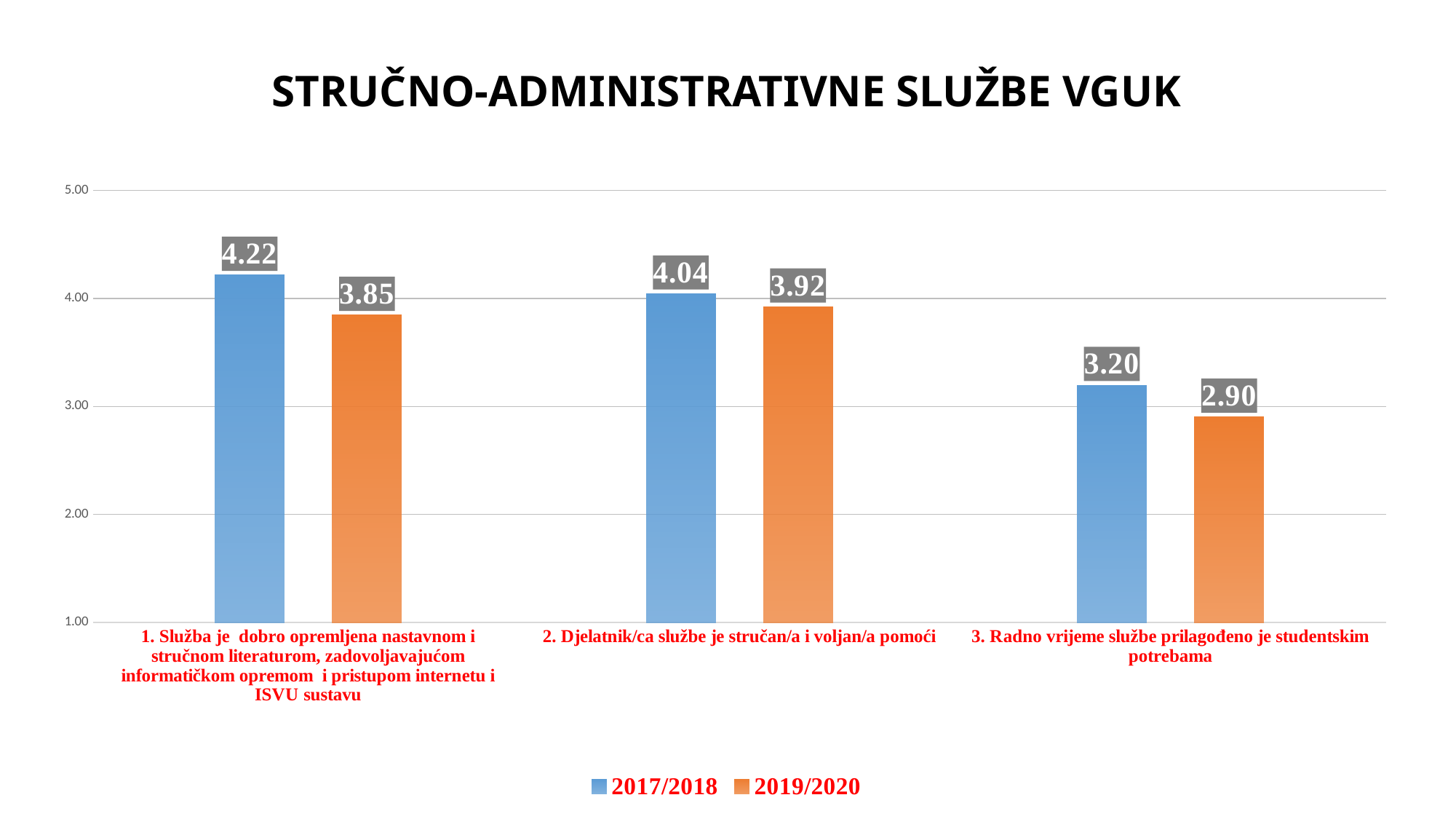
Which category has the highest 2017/2018 value? 1. Služba je dobro opremljena nastavnom i stručnom literaturom, zadovoljavajućom informatičkom opremom i pristupom internetu i ISVU sustavu Which category has the lowest 2019/2020 value? 3. Radno vrijeme službe prilagođeno je studentskim potrebama How many series does the legend list? 2 How many categories are shown on the x axis? 3 What kind of chart is shown on the slide? bar chart What is the difference between the 2017/2018 and 2019/2020 values for category 3? 0.30 What is the 2017/2018 value for category 1 (Služba je dobro opremljena nastavnom i stručnom literaturom...)? 4.22 What is the 2019/2020 value for category 2 (Djelatnik/ca službe je stručan/a i voljan/a pomoći)? 3.92 Is the 2019/2020 value for category 3 greater or less than 3.00? less Which is larger for category 2: the 2017/2018 value or the 2019/2020 value? 2017/2018 What is the difference between the 2017/2018 and 2019/2020 values for category 1? 0.37 What is the 2019/2020 value for category 3 (Radno vrijeme službe prilagođeno je studentskim potrebama)? 2.90